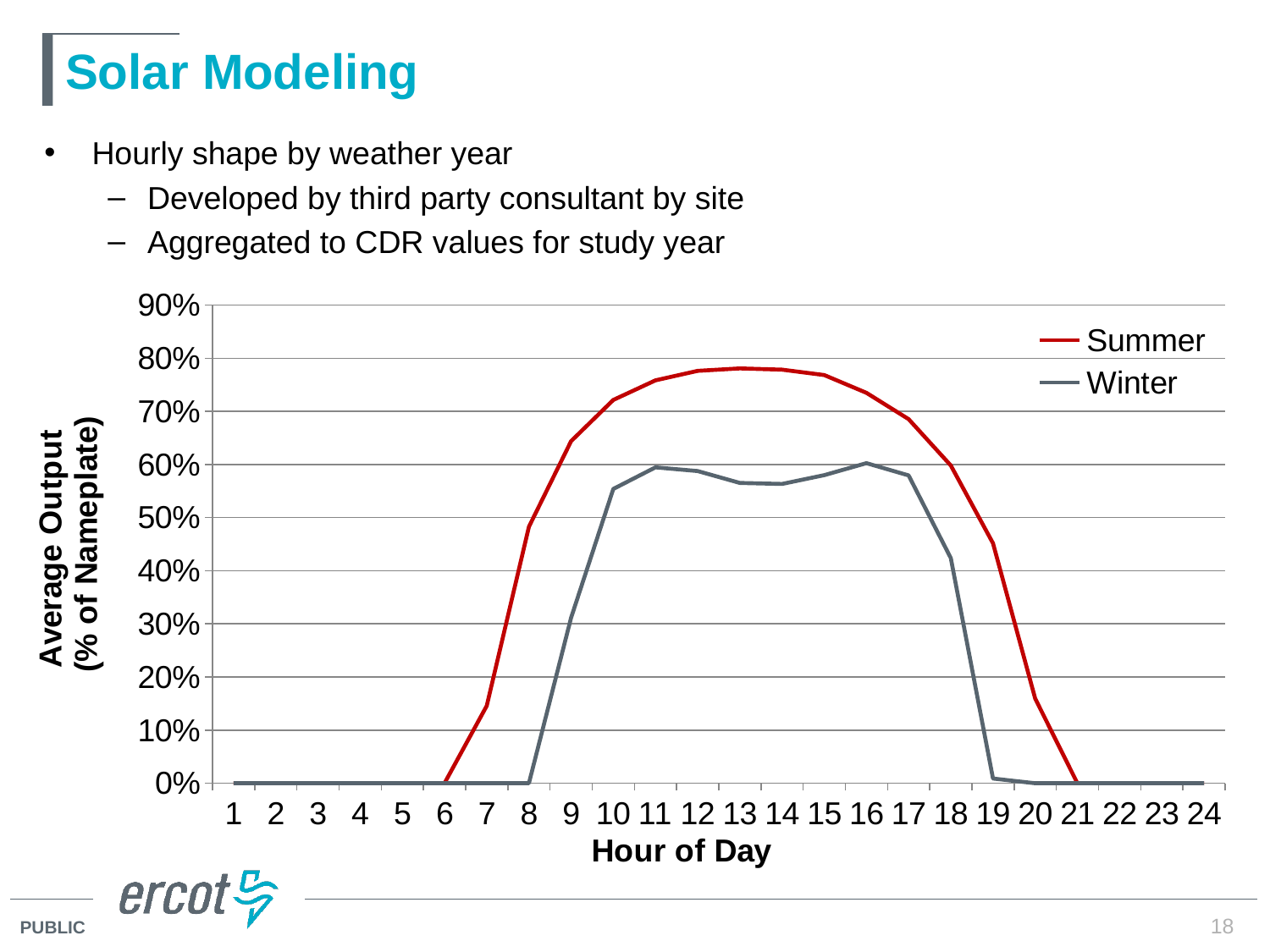
Is the Summer value at hour 7 greater or less than 20%? less At hour 12, which series has the higher average output, Summer or Winter? Summer Does the Summer average output rise or fall from hour 17 to hour 21? fall What is the Winter average output at hour 23? 0% Which series reaches the higher peak average output? Summer Is the Winter value at hour 13 greater or less than 60%? less What kind of chart is shown on the slide? line chart Is the Winter value at hour 9 greater or less than 40%? less What is the Summer average output at hour 3? 0% How many series does the legend list? 2 How many hours of the day are plotted along the x axis? 24